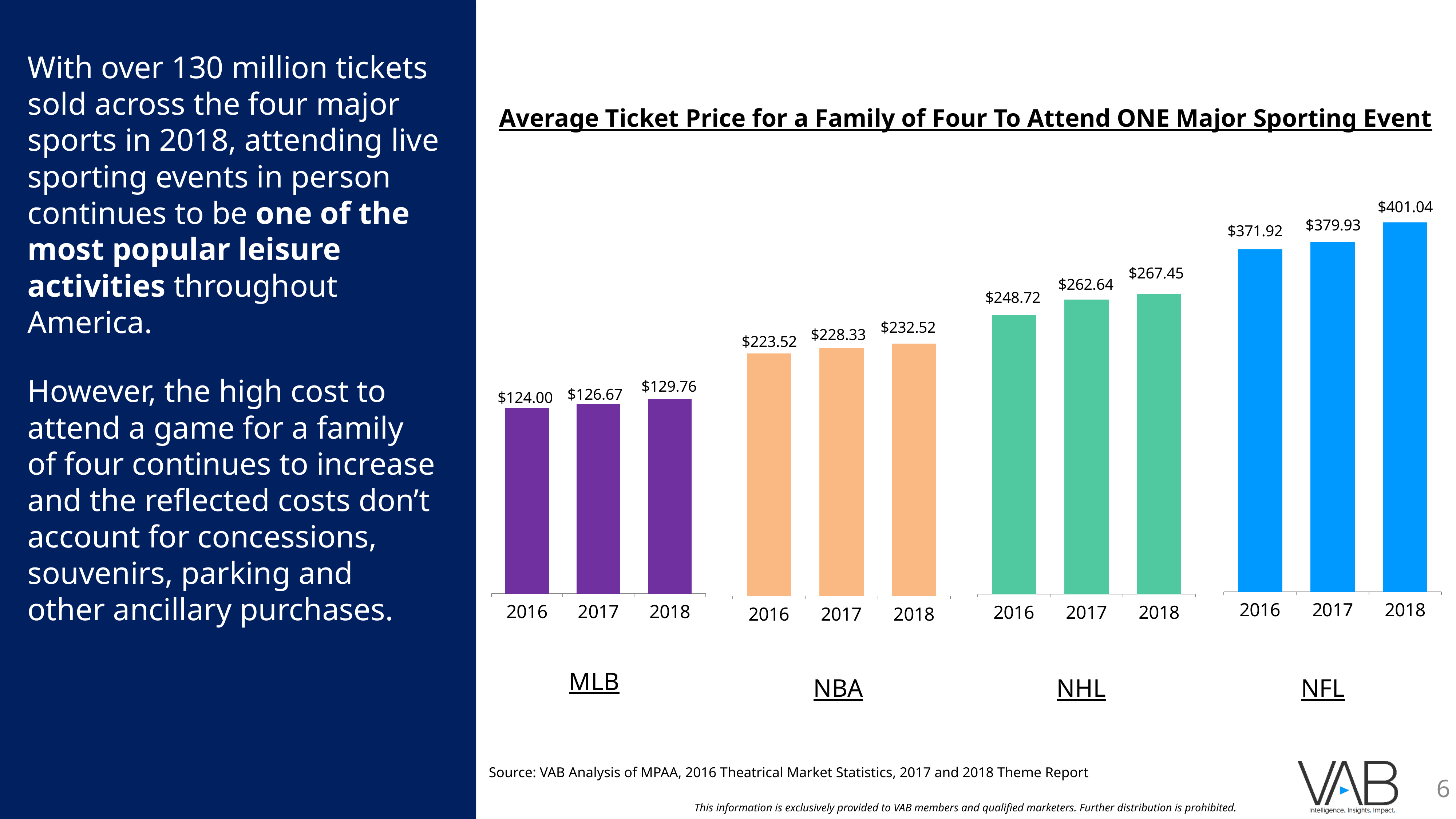
In the NFL chart, what is the difference between the 2018 and 2016 average ticket prices? $29.12 In the NBA chart, what is the average ticket price for 2018? $232.52 In the NHL chart, what is the average ticket price for 2017? $262.64 In the MLB chart, what is the average ticket price for 2016? $124.00 In the MLB chart, what is the difference between the 2018 and 2016 average ticket prices? $5.76 In the NHL chart, which year has the lowest average ticket price? 2016 Which is larger: the NBA 2018 average ticket price or the NHL 2016 average ticket price? NHL 2016 How many years are shown in the NBA chart? 3 In the NFL chart, what is the average ticket price for 2018? $401.04 What kind of chart is used for the NHL data? bar chart In the MLB chart, do the average ticket prices rise or fall from 2016 to 2018? rise In the NFL chart, which year has the highest average ticket price? 2018